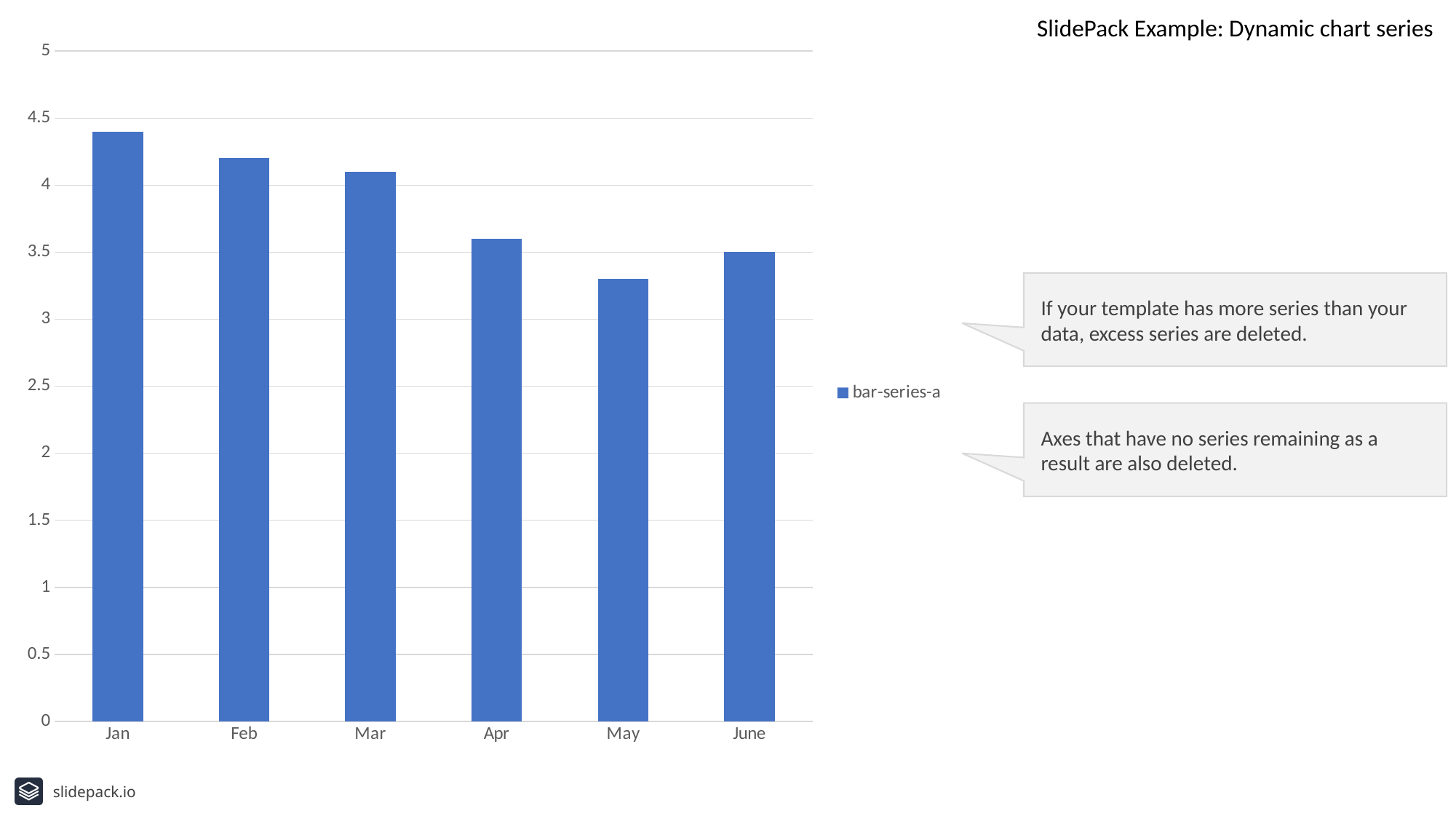
Is the value for May greater or less than 3.5? less Which month has the highest bar in the chart? Jan What kind of chart is shown on the slide? bar chart Which month has the lowest bar in the chart? May Is the value for Jan greater or less than 4? greater Do the bar values generally rise or fall from Jan to June? fall Which is larger, the value for Feb or the value for Apr? Feb How many series does the chart's legend list? 1 What is the name of the series shown in the chart's legend? bar-series-a Is the value for Apr greater or less than 4? less How many categories are shown on the x axis of the chart? 6 What is the title shown at the top of the slide? SlidePack Example: Dynamic chart series